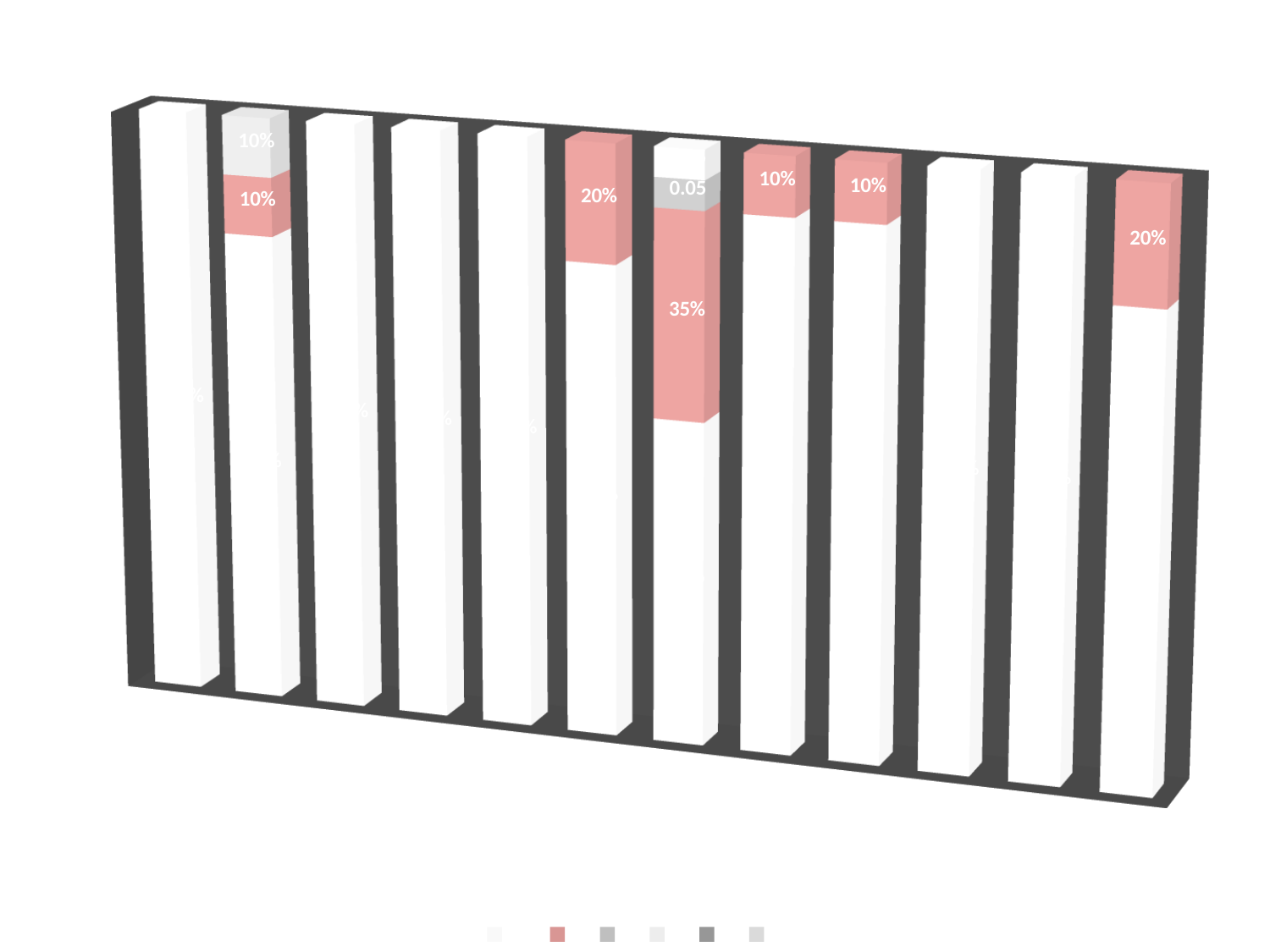
What is the value of the pink segment in the seventh bar from the left? 35% What is the value of the pink segment in the eighth bar from the left? 10% What value is printed on the grey segment at the top of the seventh bar from the left? 0.05 What is the difference between the pink segment of the seventh bar (35%) and the pink segment of the sixth bar (20%)? 15% What is the value of the pink segment in the sixth bar from the left? 20% Is the pink segment of the sixth bar from the left larger or smaller than the pink segment of the eighth bar? Larger What kind of chart is shown on the slide? Stacked bar chart What is the value of the grey segment at the top of the second bar from the left? 10% How many bars are plotted in the chart? 12 How many series does the legend list? 6 What is the value of the pink segment in the twelfth (rightmost) bar? 20% Which bar has the largest pink segment? The seventh bar from the left